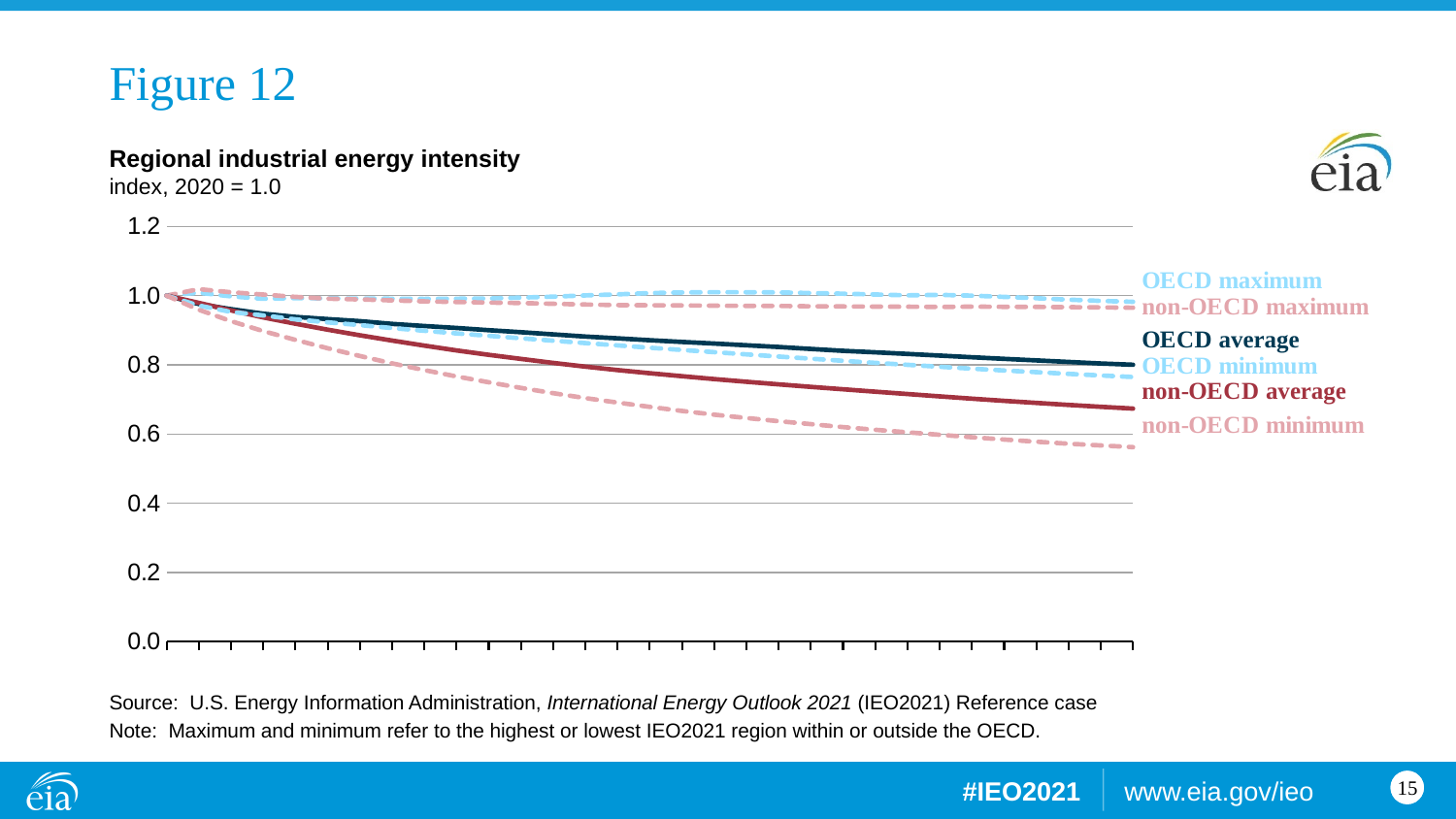
Does the OECD average series rise or fall along the x axis? fall At the right end of the chart, which is larger: OECD average or non-OECD average? OECD average Is the value for non-OECD average at the right end of the chart greater or less than 0.8? less How many series are labelled on the chart? 6 What unit or index is the chart's y axis expressed in, according to the subtitle? index, 2020 = 1.0 Does the non-OECD average series rise or fall along the x axis? fall Which series has the lowest value at the right end of the chart? non-OECD minimum What kind of chart is shown on the slide? line chart What is the title of the chart? Regional industrial energy intensity Which series has the highest value at the right end of the chart? OECD maximum Is the value for non-OECD minimum at the right end of the chart greater or less than 0.6? less